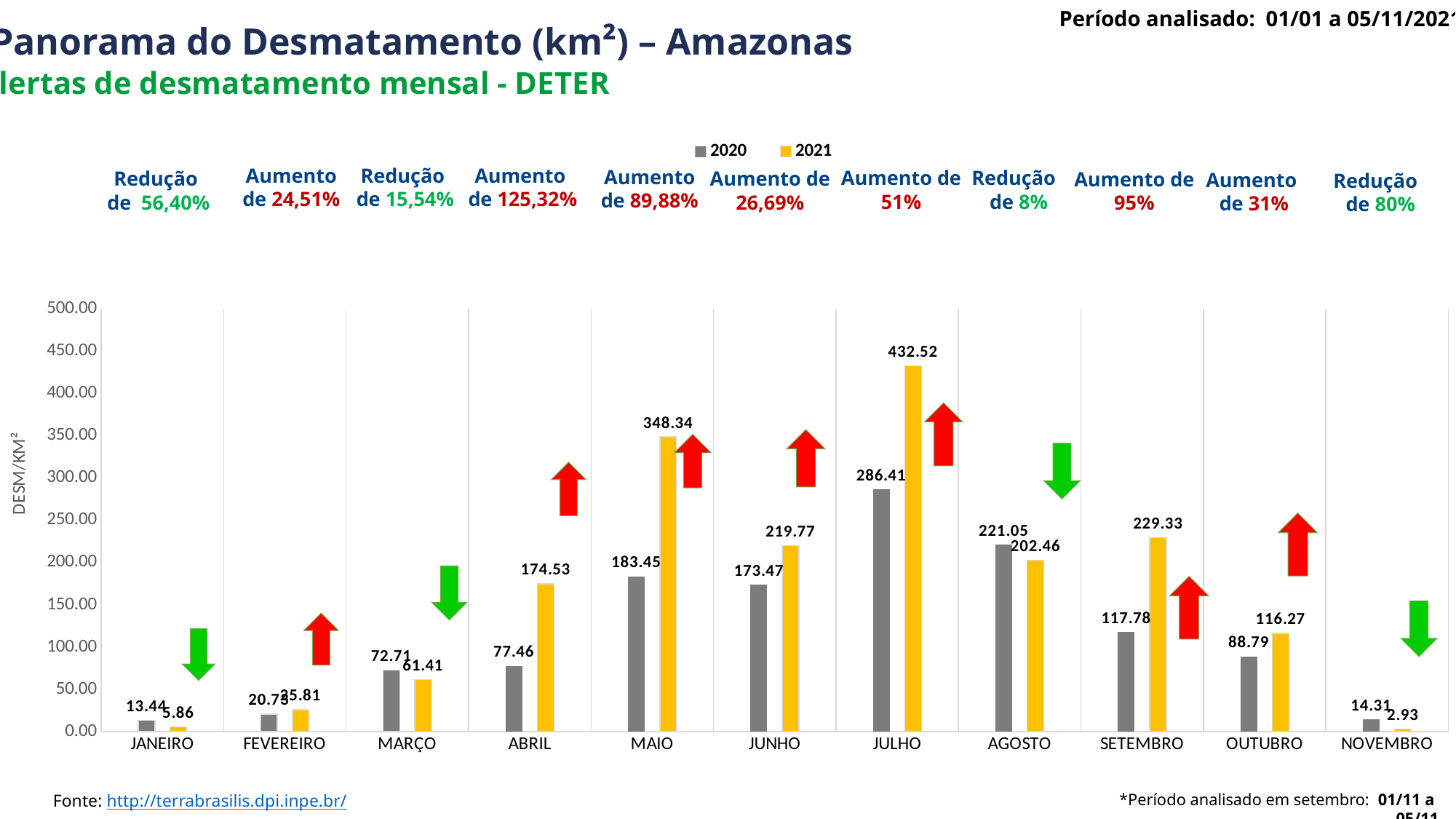
What is the label of the y axis? DESM/KM² What is the 2021 value for JULHO? 432.52 What is the 2020 value for MAIO? 183.45 What kind of chart is shown on the slide? bar chart What is the difference between the 2021 and 2020 values for ABRIL? 97.07 Is the 2021 value for MAIO greater or less than 300.00? greater Which month has the highest 2021 value? JULHO Which is larger for AGOSTO, the 2020 value or the 2021 value? 2020 How many series does the legend list? 2 What is the 2021 value for SETEMBRO? 229.33 Which month has the lowest 2021 value? NOVEMBRO How many months are shown on the x axis? 11